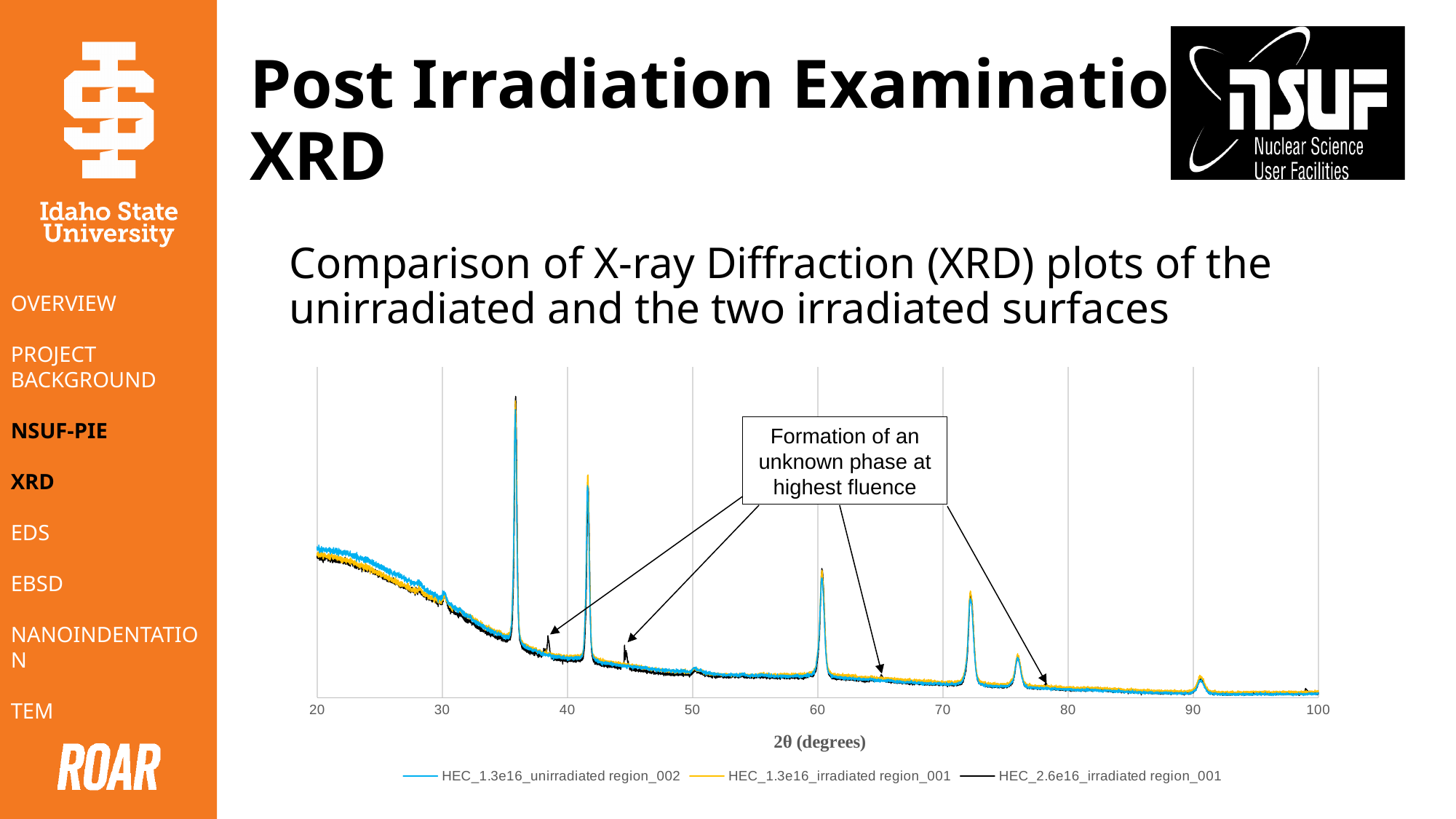
Is the tallest peak in the XRD chart located at a 2θ value greater or less than 40 degrees? less What is the label of the x axis of the XRD chart? 2θ (degrees) What does the annotation box on the XRD chart say? Formation of an unknown phase at highest fluence How many series does the legend of the XRD chart list? 3 Does the background intensity of the XRD curves generally rise or fall as 2θ increases from 20 to 100 degrees? fall What kind of chart is shown on the slide? line chart